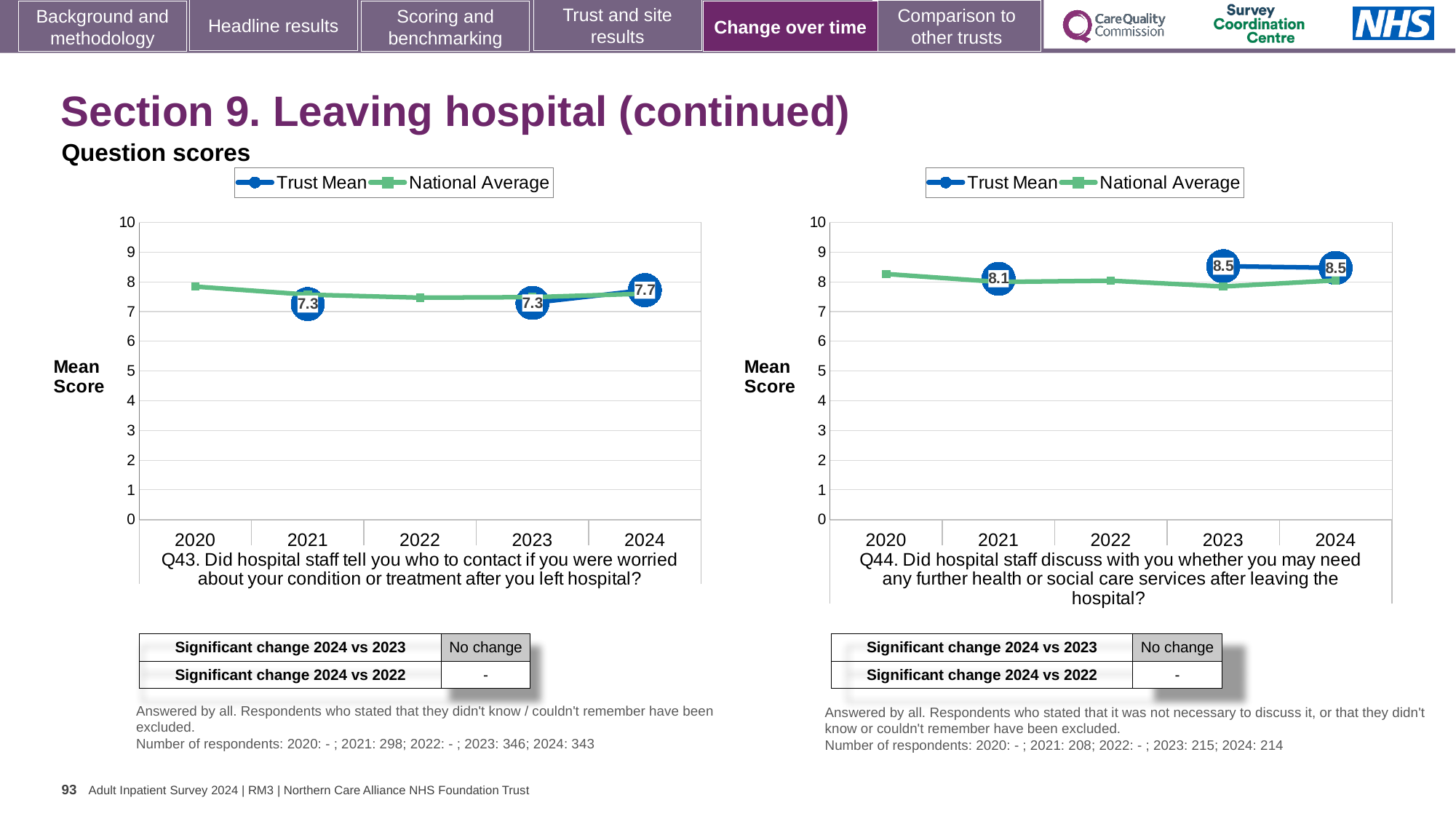
In the Q44 chart on the right, which year has the lowest labelled Trust Mean score? 2021 In the Q43 chart on the left, what is the Trust Mean score for 2021? 7.3 In the Q44 chart on the right, what is the Trust Mean score for 2023? 8.5 In the Q44 chart on the right, what is the difference between the Trust Mean scores for 2023 and 2021? 0.4 In the Q43 chart on the left, what is the difference between the Trust Mean scores for 2024 and 2023? 0.4 How many series does the legend of the Q44 chart on the right list? 2 How many years are shown on the x axis of the Q44 chart on the right? 5 In the Q43 chart on the left, is the National Average for 2020 greater or less than 7? greater In the Q44 chart on the right, what is the Trust Mean score for 2021? 8.1 In the Q43 chart on the left, which year has the highest labelled Trust Mean score? 2024 What kind of chart is the Q43 chart on the left? Line chart In the Q43 chart on the left, what is the Trust Mean score for 2024? 7.7